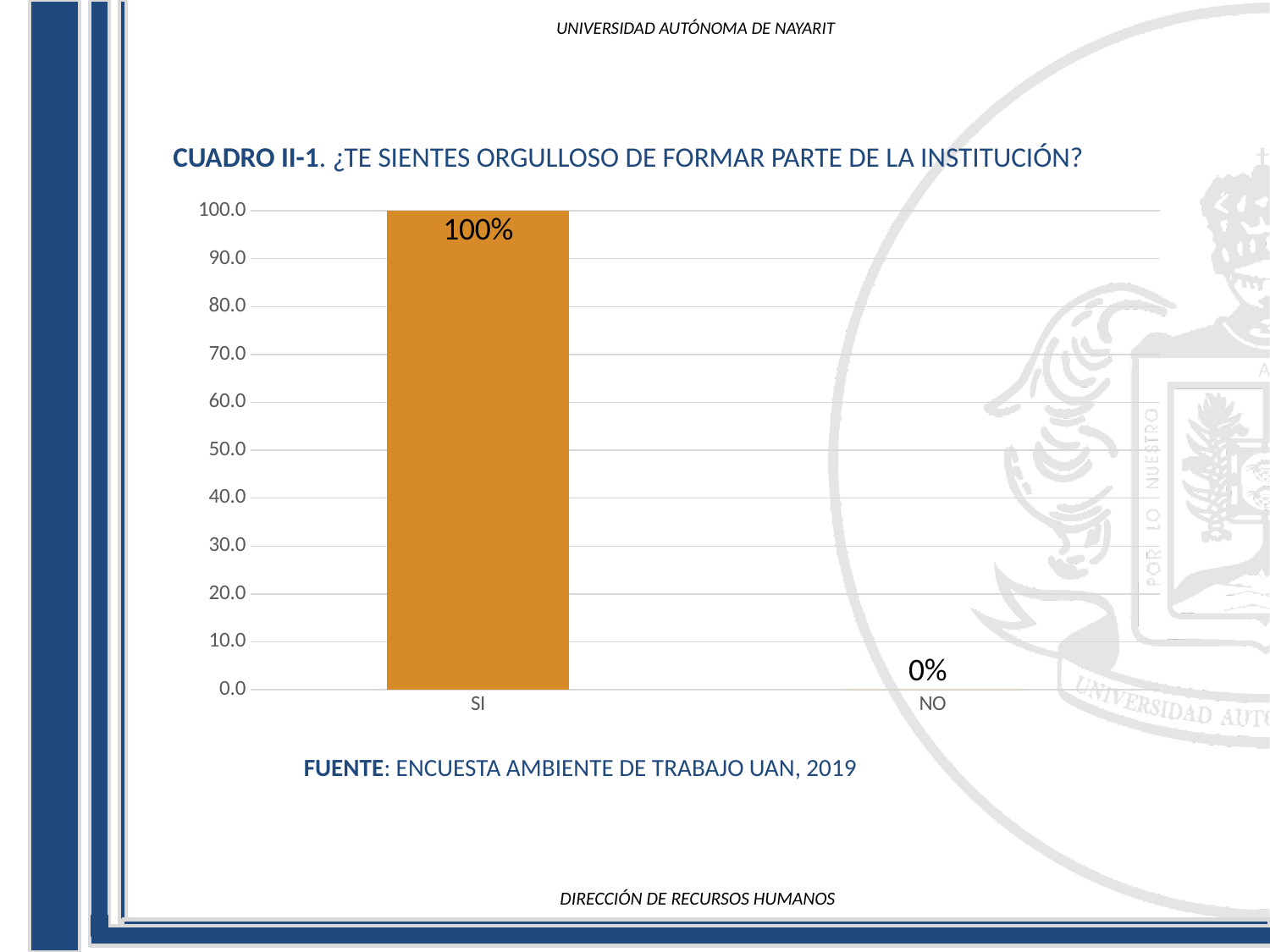
What is the difference between the values for SI and NO? 100% What is the maximum value shown on the y axis? 100.0 Is the value for SI greater or less than 50.0? greater How many categories are shown on the x axis? 2 What is the value for SI? 100% What is the source cited below the chart? ENCUESTA AMBIENTE DE TRABAJO UAN, 2019 Which category has the highest value? SI Which is larger, the value for SI or the value for NO? SI What is the value for NO? 0% Which category has the lowest value? NO What kind of chart is shown on the slide? bar chart